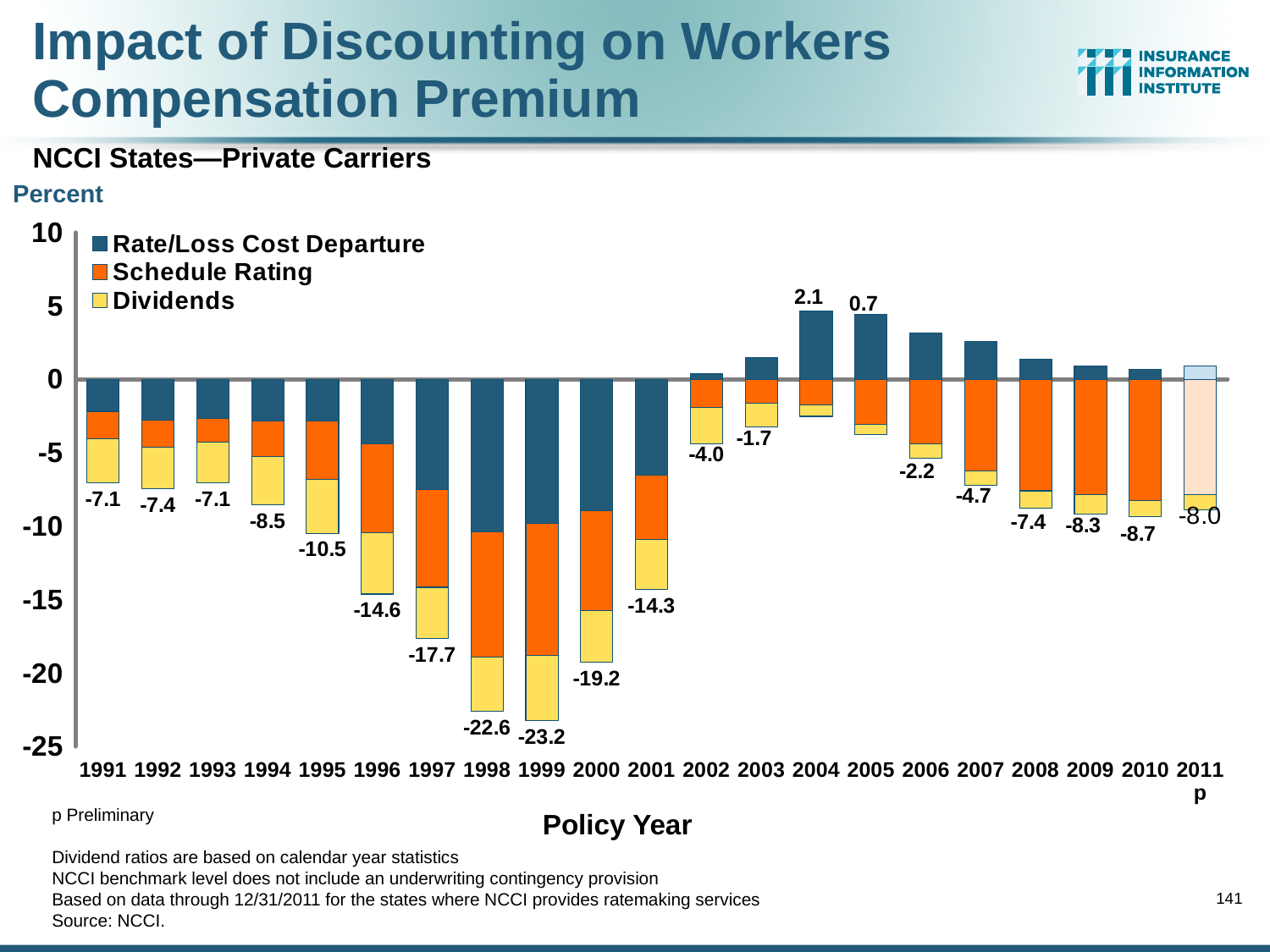
What is the difference between the labeled net totals for 1998 and 1999? 0.6 What is the net total labeled for policy year 2011p? -8.0 Which policy year has the lowest (most negative) labeled net total? 1999 Which policy year has a larger labeled net total, 2004 or 2005? 2004 How many series does the legend list? 3 What is the net total labeled for policy year 1999? -23.2 Which policy year has the highest labeled net total? 2004 What kind of chart is shown on the slide? Stacked bar chart How many policy years are shown on the x axis? 21 Do the labeled net totals rise or fall from 1991 to 1999? Fall What is the net total labeled for policy year 2004? 2.1 What is the difference between the labeled net totals for 2009 and 2010? 0.4